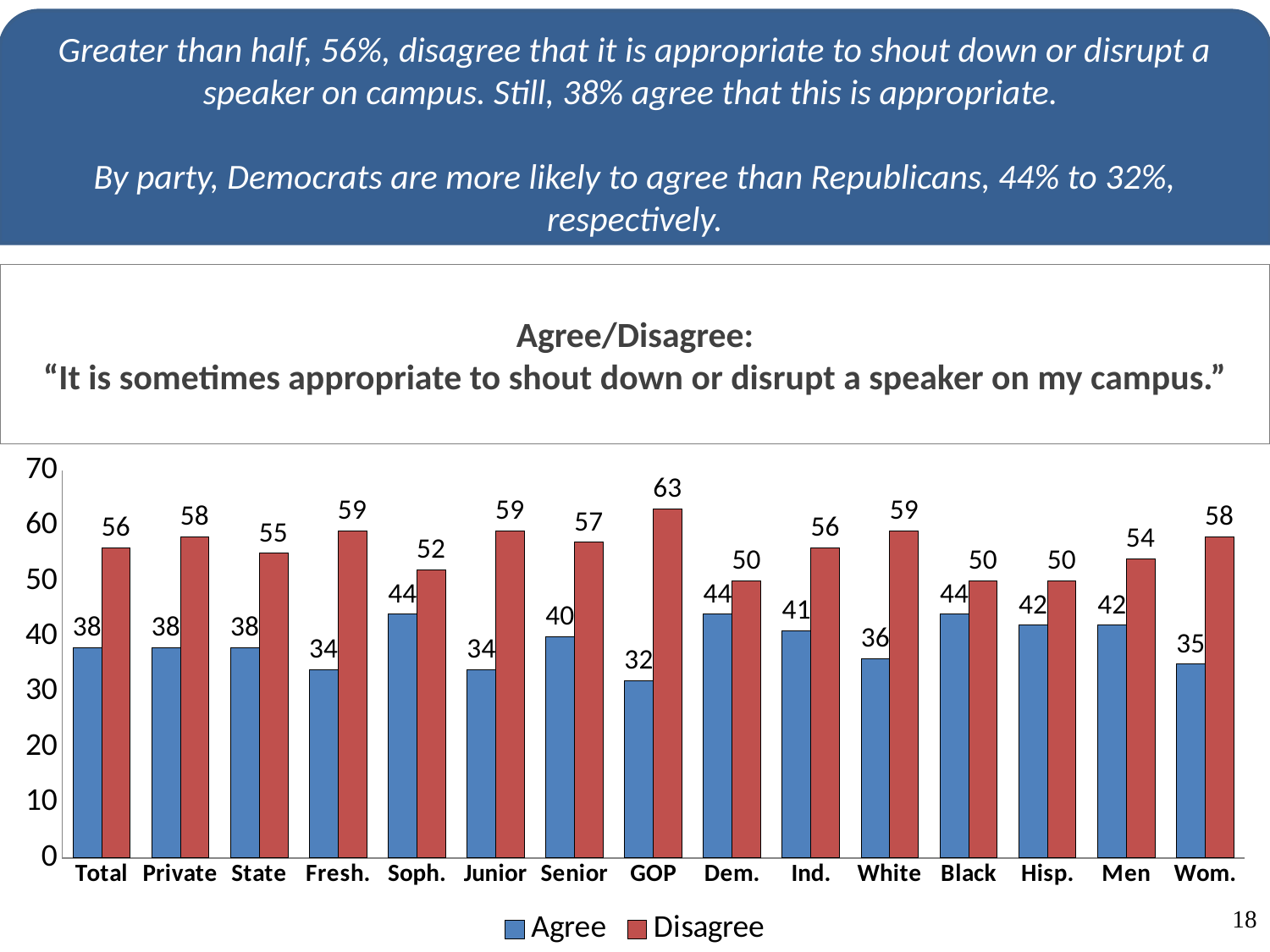
Which colour represents the Disagree series? Red What is the difference between the Agree values for Dem. and GOP? 12 What is the Agree value for GOP? 32 Which category has the highest Disagree value? GOP What is the difference between the Disagree and Agree values for Total? 18 How many categories are shown on the x axis? 15 Which category has the lowest Agree value? GOP What is the Agree value for Wom.? 35 Which is larger, the Agree value for Men or the Agree value for Wom.? Men What is the Disagree value for Soph.? 52 What kind of chart is shown on the slide? Bar chart How many series does the legend list? 2